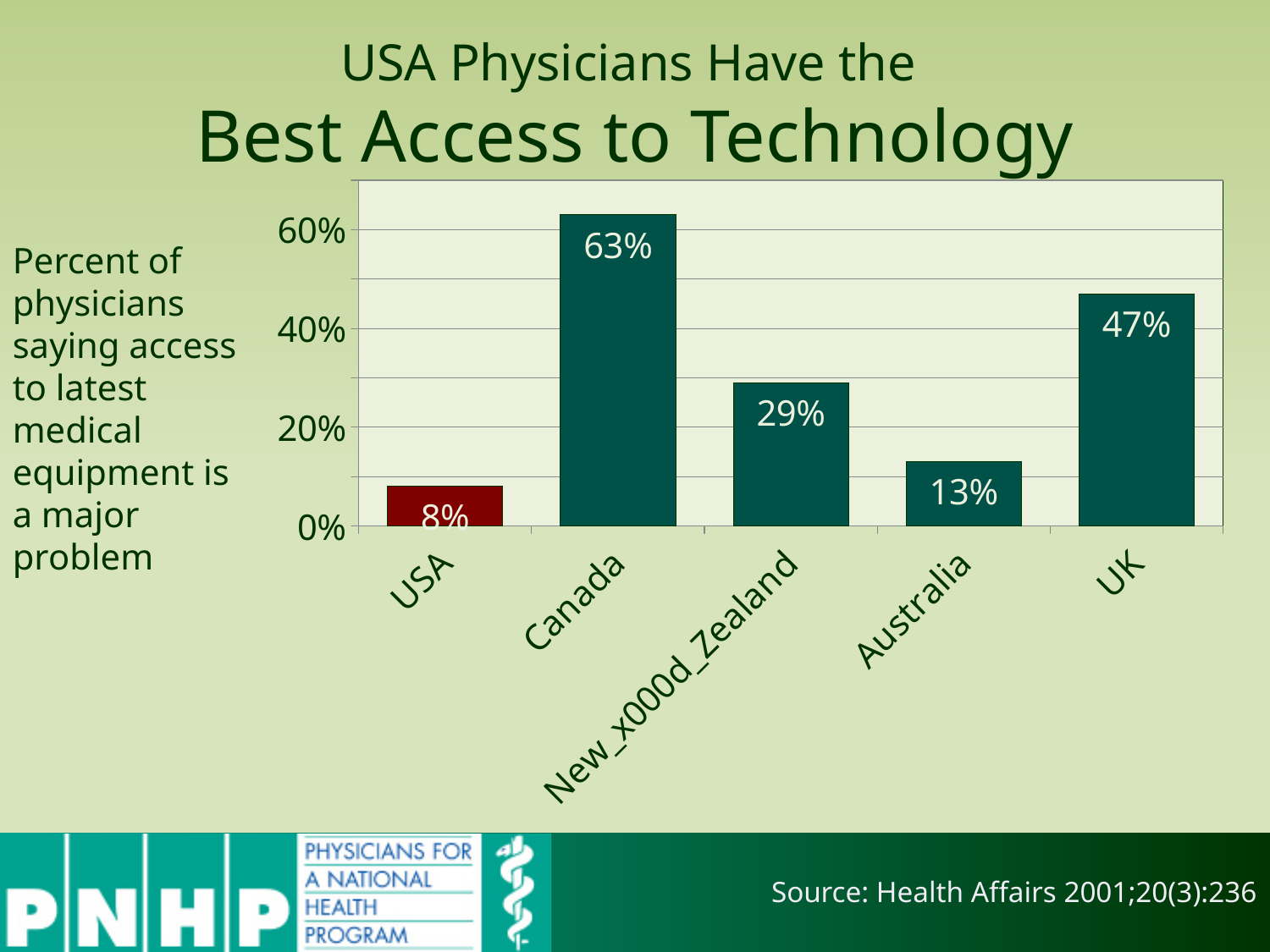
Which country has the highest percentage of physicians saying access to the latest medical equipment is a major problem? Canada How many countries are shown in the chart? 5 Which has a larger value, the UK or Australia? UK What is the value shown for Canada? 63% What percent of USA physicians say access to the latest medical equipment is a major problem? 8% Which country has the lowest percentage in the chart? USA What is the value shown for Australia? 13% What is the value shown for the UK? 47% What is the difference between the values for Canada and the UK? 16% What kind of chart is shown on the slide? Bar chart Which bar is shown in a different colour (dark red) from the others? USA What is the difference between the values for Australia and the USA? 5%